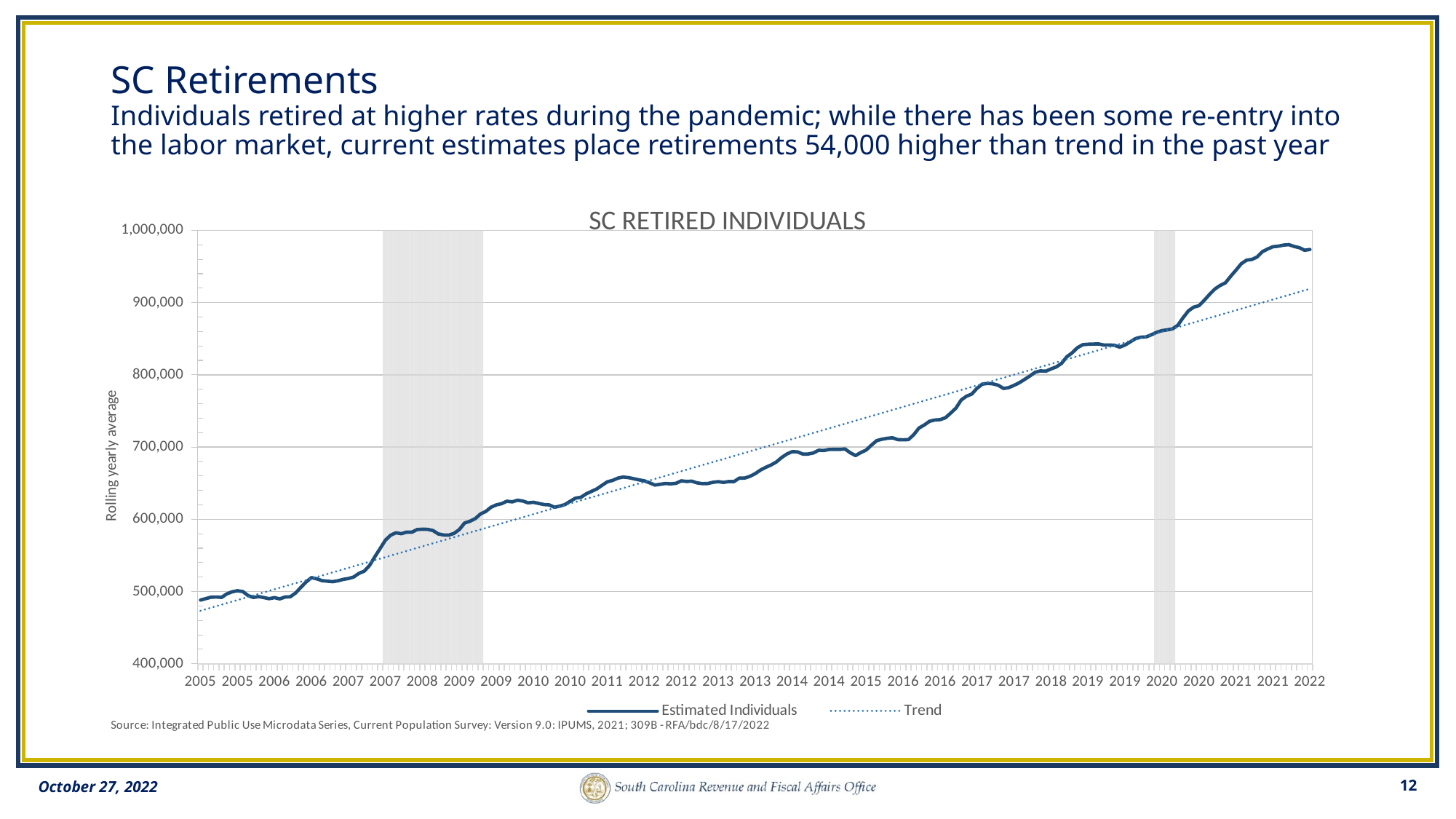
What type of chart is shown on the slide? Line chart Is the value of Estimated Individuals at 2022 greater or less than 900,000? greater Does the Estimated Individuals line generally rise or fall from 2005 to 2022? Rise How many series does the legend list? 2 Is the value of Estimated Individuals at 2010 greater or less than 600,000? greater In which year does the Estimated Individuals line reach its highest value? 2022 Is the value of Estimated Individuals at the start of 2005 greater or less than 500,000? less What are the two series named in the legend? Estimated Individuals and Trend At 2022, which series has the higher value, Estimated Individuals or Trend? Estimated Individuals At 2013, which series has the higher value, Estimated Individuals or Trend? Trend What is the title of the chart? SC RETIRED INDIVIDUALS